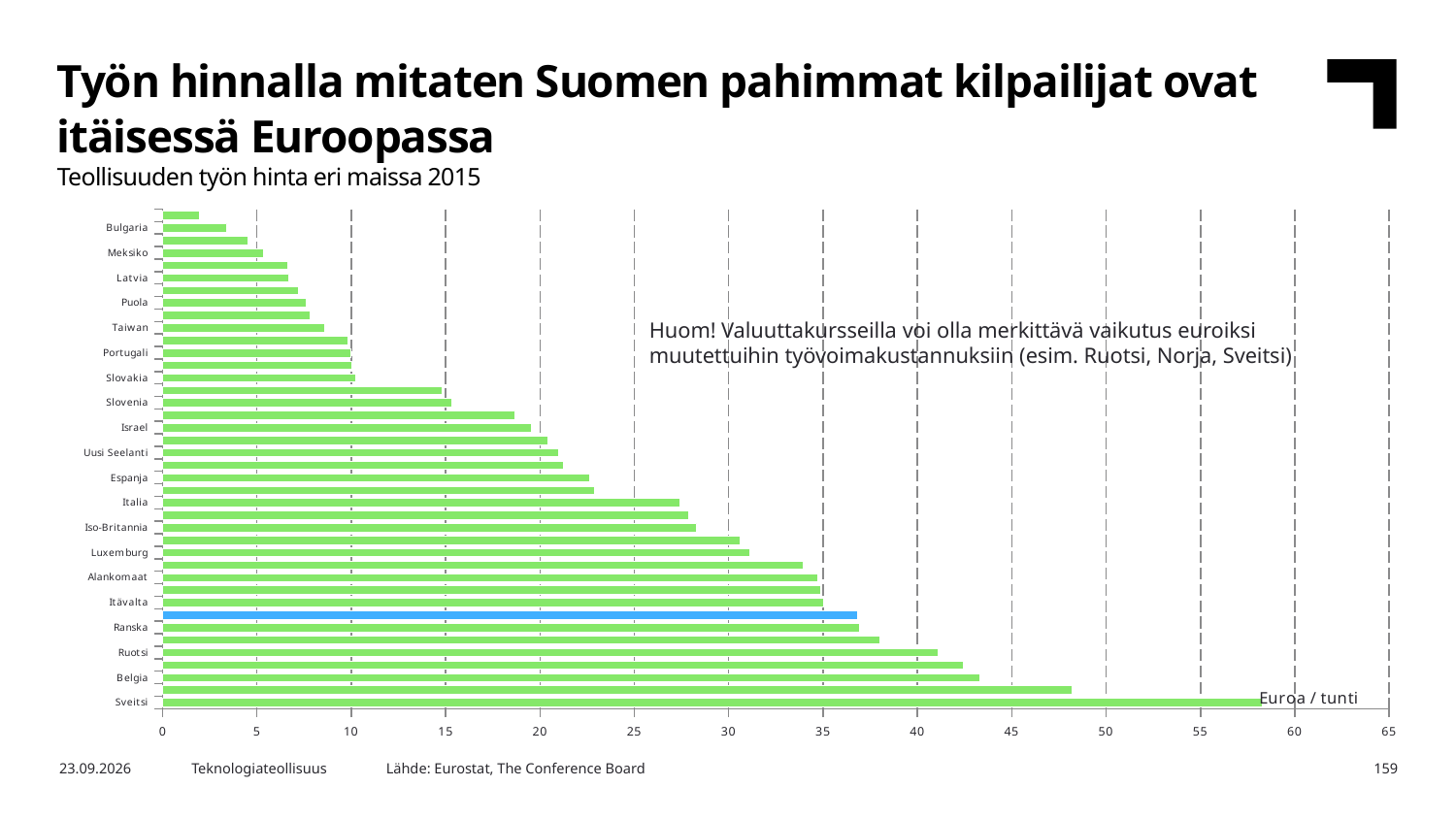
What colour is the single highlighted bar that differs from the others? blue Is the value for Belgia greater or less than 40? greater Is the value for Bulgaria greater or less than 5? less Is the value for Sveitsi greater or less than 55? greater What unit is shown for the values in the chart? Euroa / tunti Which has a higher value, Bulgaria or Latvia? Latvia What kind of chart is shown on the slide? bar chart Which has a higher value, Ruotsi or Ranska? Ruotsi Which country has the highest labour cost in the chart? Sveitsi